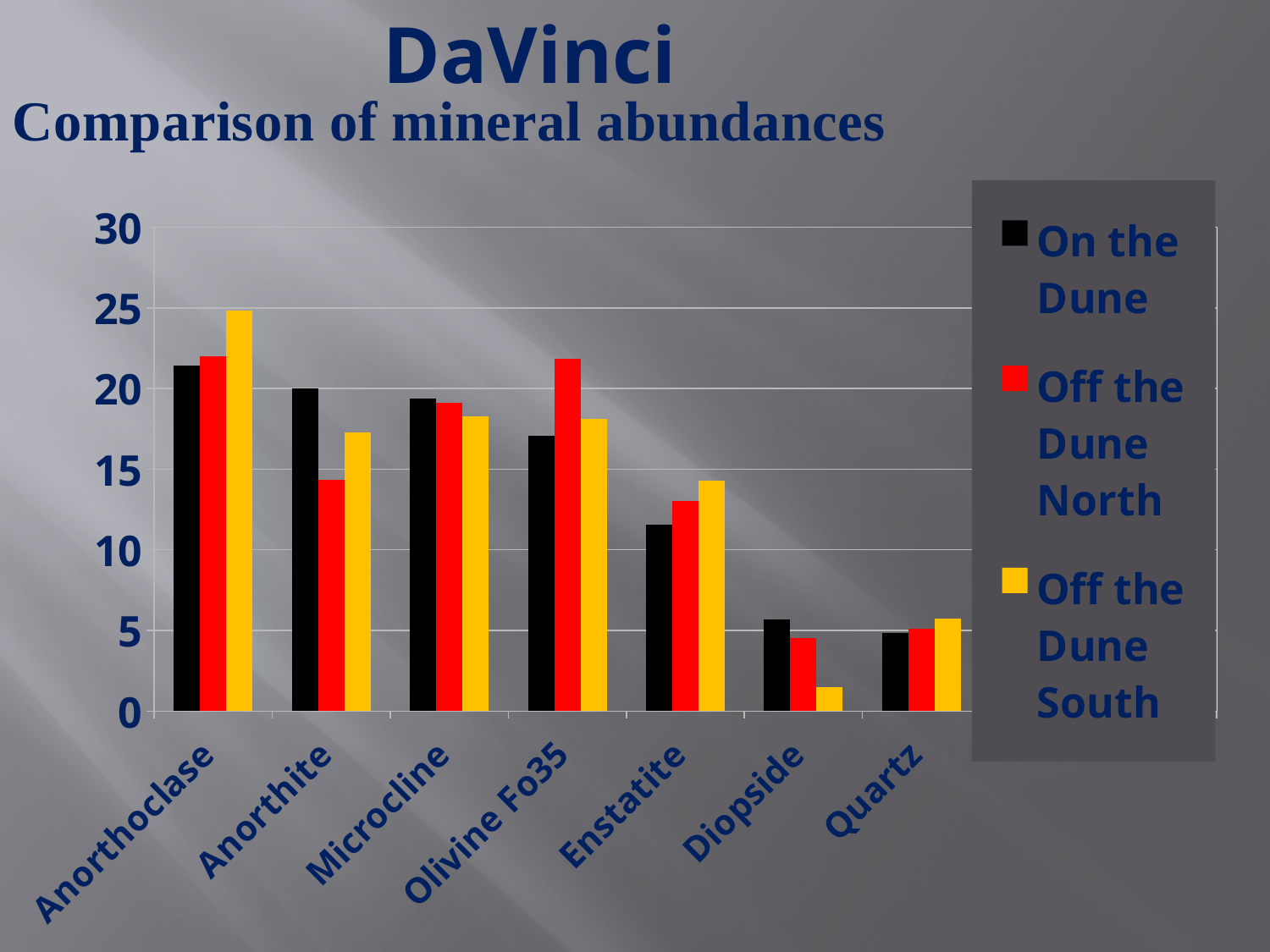
Is the On the Dune value for Enstatite greater or less than 10? greater How many minerals are shown along the x axis of the chart? 7 What is the title of the chart below the heading 'DaVinci'? Comparison of mineral abundances How many series does the chart's legend list? 3 Which mineral has the highest Off the Dune South value? Anorthoclase Is the Off the Dune South value for Diopside greater or less than 5? less Is the Off the Dune North value for Anorthite greater or less than 15? less For Olivine Fo35, which is larger: the On the Dune value or the Off the Dune North value? Off the Dune North For Anorthite, which is larger: the On the Dune value or the Off the Dune North value? On the Dune Which mineral has the lowest Off the Dune South value? Diopside What kind of chart is shown on the slide? bar chart